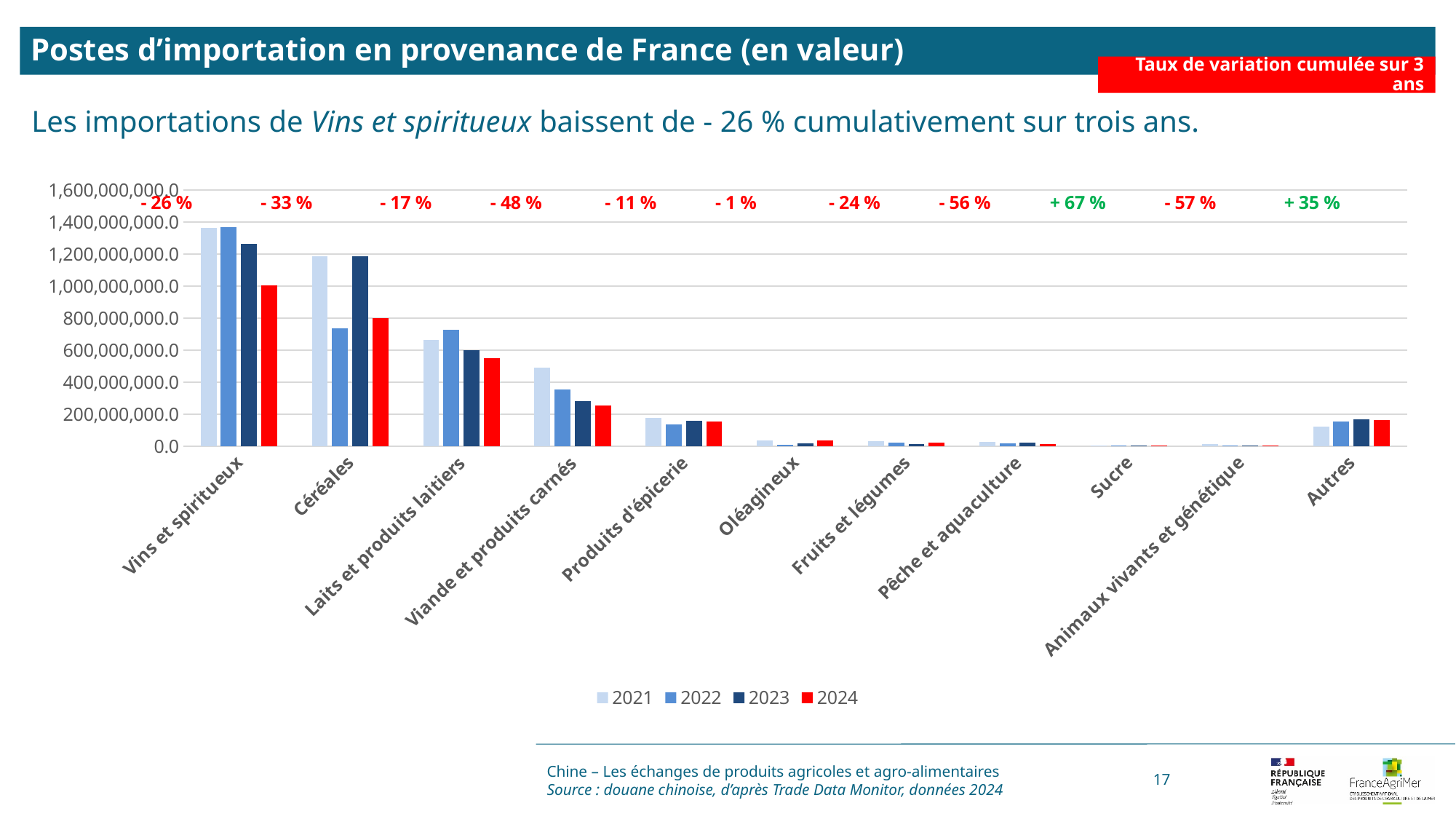
Is the 2022 value for Céréales greater or less than 800,000,000.0? less How many series does the legend list? 4 What is the cumulative 3-year variation rate printed above Viande et produits carnés? - 48 % Which category has the lowest (most negative) cumulative 3-year variation rate? Animaux vivants et génétique Which category has the highest 2024 bar? Vins et spiritueux Do the bars for Viande et produits carnés rise or fall from 2021 to 2024? fall What kind of chart is shown on the slide? bar chart What is the cumulative 3-year variation rate printed above Pêche et aquaculture? - 56 % How many import categories are shown on the x axis? 11 For Céréales, which is larger: the 2022 bar or the 2023 bar? 2023 What is the cumulative 3-year variation rate printed above Vins et spiritueux? - 26 % Is the 2021 value for Céréales greater or less than 1,000,000,000.0? greater